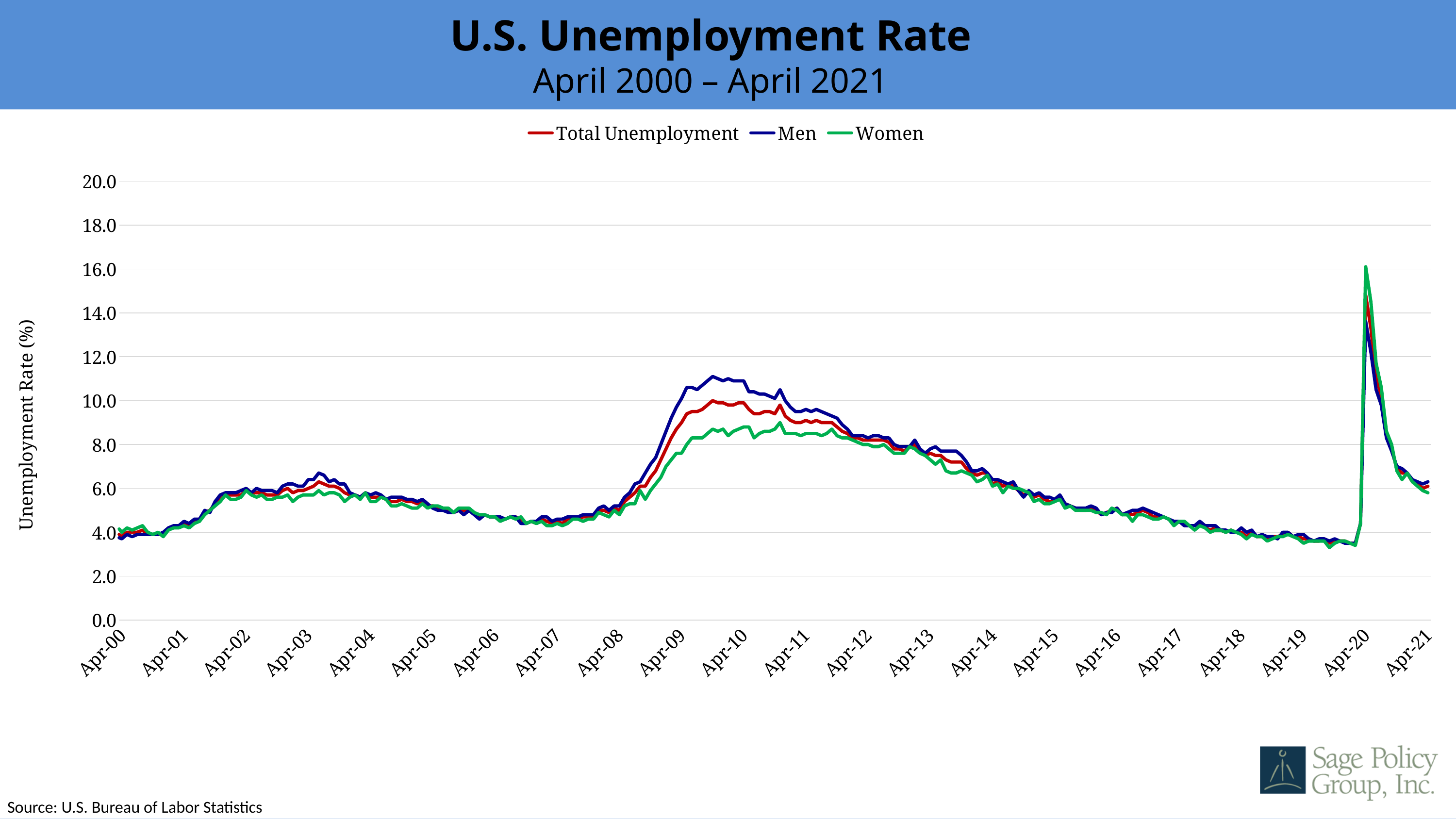
How many series does the legend list? 3 What kind of chart is shown on the slide? line chart Is the peak value for Women around Apr-20 greater or less than 14.0? greater At the spike around Apr-20, which series reaches a higher value, Men or Women? Women Around Apr-10, which series is higher, Men or Women? Men Which series reaches the highest value anywhere on the chart? Women Between Apr-10 and Apr-19, do the unemployment rates generally rise or fall? fall Is the value for Women around Apr-10 greater or less than 10.0? less What is the source cited at the bottom of the slide? U.S. Bureau of Labor Statistics Is the peak value for Men around Apr-10 greater or less than 10.0? greater What is the label of the y axis? Unemployment Rate (%) How many year labels are shown along the x axis? 22